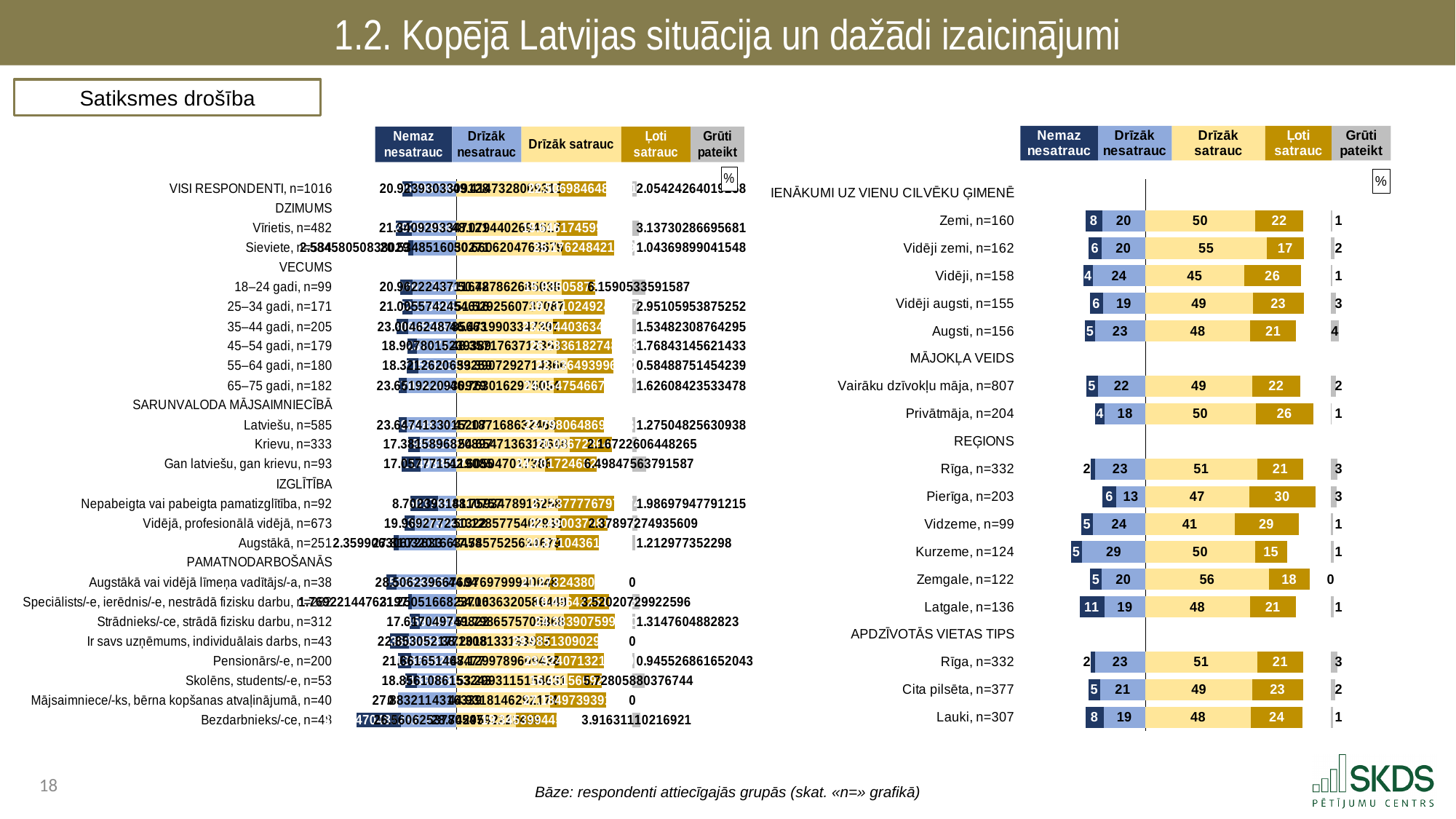
In the right chart, what is the value of "Grūti pateikt" for Augsti, n=156? 4 In the right chart, what is the difference between the "Drīzāk satrauc" values for Vidēji zemi, n=162 and Vidēji, n=158? 10 In the right chart, what is the value of "Nemaz nesatrauc" for Latgale, n=136? 11 In the right chart, how many income categories are listed under IENĀKUMI UZ VIENU CILVĒKU ĢIMENĒ? 5 In the right chart, what is the value of "Drīzāk satrauc" for Zemgale, n=122? 56 In the right chart, which region under REĢIONS has the lowest "Ļoti satrauc" value? Kurzeme, n=124 How many series does the legend of the right chart list? 5 In the right chart, what is the value of "Ļoti satrauc" for Pierīga, n=203? 30 What kind of chart is the right chart? Stacked bar chart In the right chart, which has the larger "Drīzāk nesatrauc" value: Kurzeme, n=124 or Vidzeme, n=99? Kurzeme, n=124 In the right chart, which income group under IENĀKUMI UZ VIENU CILVĒKU ĢIMENĒ has the highest "Drīzāk satrauc" value? Vidēji zemi, n=162 In the right chart, which region under REĢIONS has the highest "Ļoti satrauc" value? Pierīga, n=203